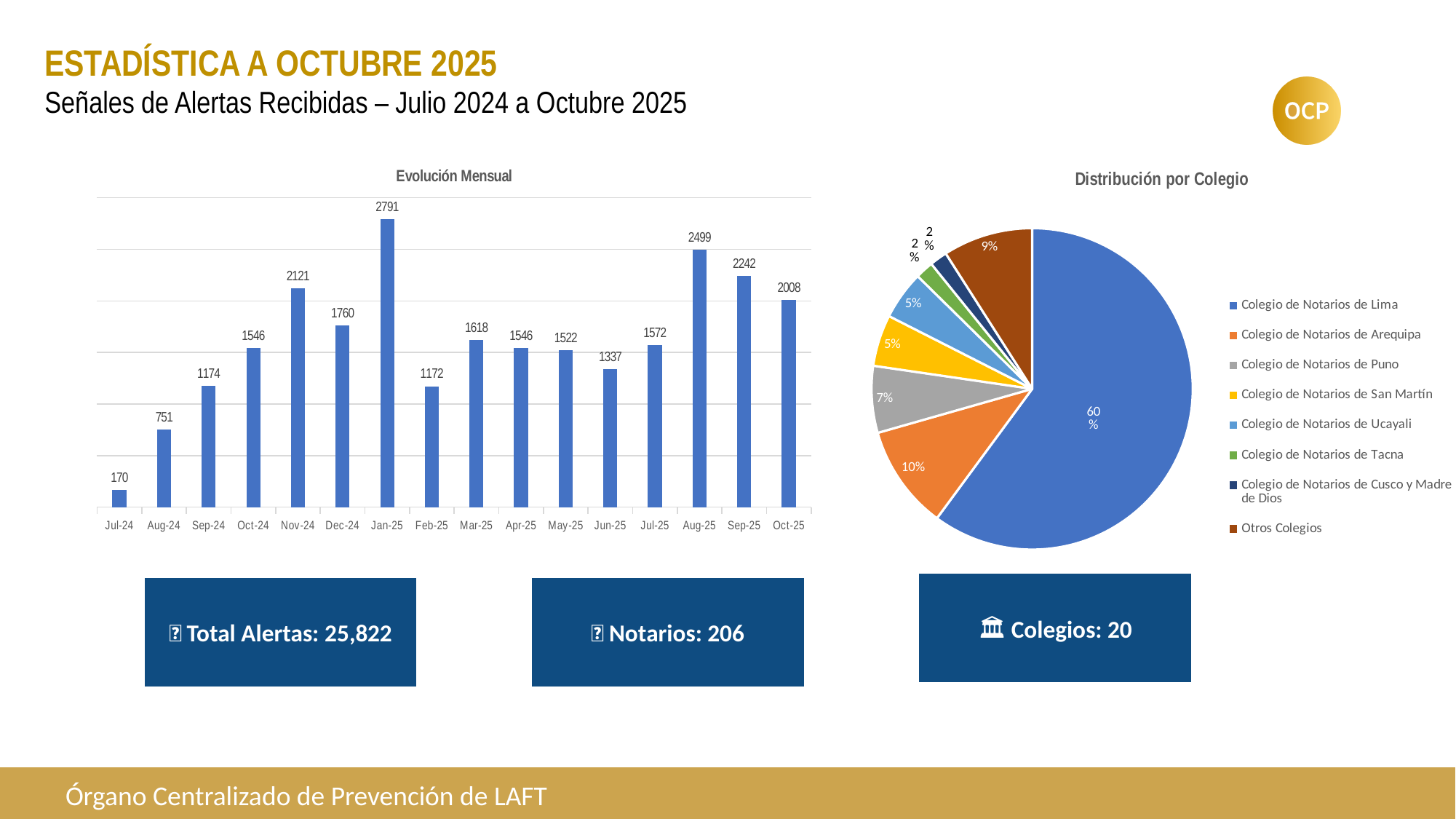
In the 'Evolución Mensual' chart, what is the value for Jan-25? 2791 In the 'Distribución por Colegio' chart, what share does Colegio de Notarios de Arequipa have? 10% In the 'Evolución Mensual' chart, what is the value for Jul-24? 170 What kind of chart is 'Distribución por Colegio'? Pie chart How many entries does the legend of the 'Distribución por Colegio' chart list? 8 In the 'Evolución Mensual' chart, what is the difference between the values for Aug-25 and Sep-25? 257 In the 'Evolución Mensual' chart, which is larger, the value for Nov-24 or the value for Dec-24? Nov-24 In the 'Distribución por Colegio' chart, what share does Colegio de Notarios de Lima have? 60% In the 'Evolución Mensual' chart, which month has the highest value? Jan-25 What kind of chart is 'Evolución Mensual'? Bar chart How many months are shown in the 'Evolución Mensual' chart? 16 In the 'Evolución Mensual' chart, which month has the lowest value? Jul-24